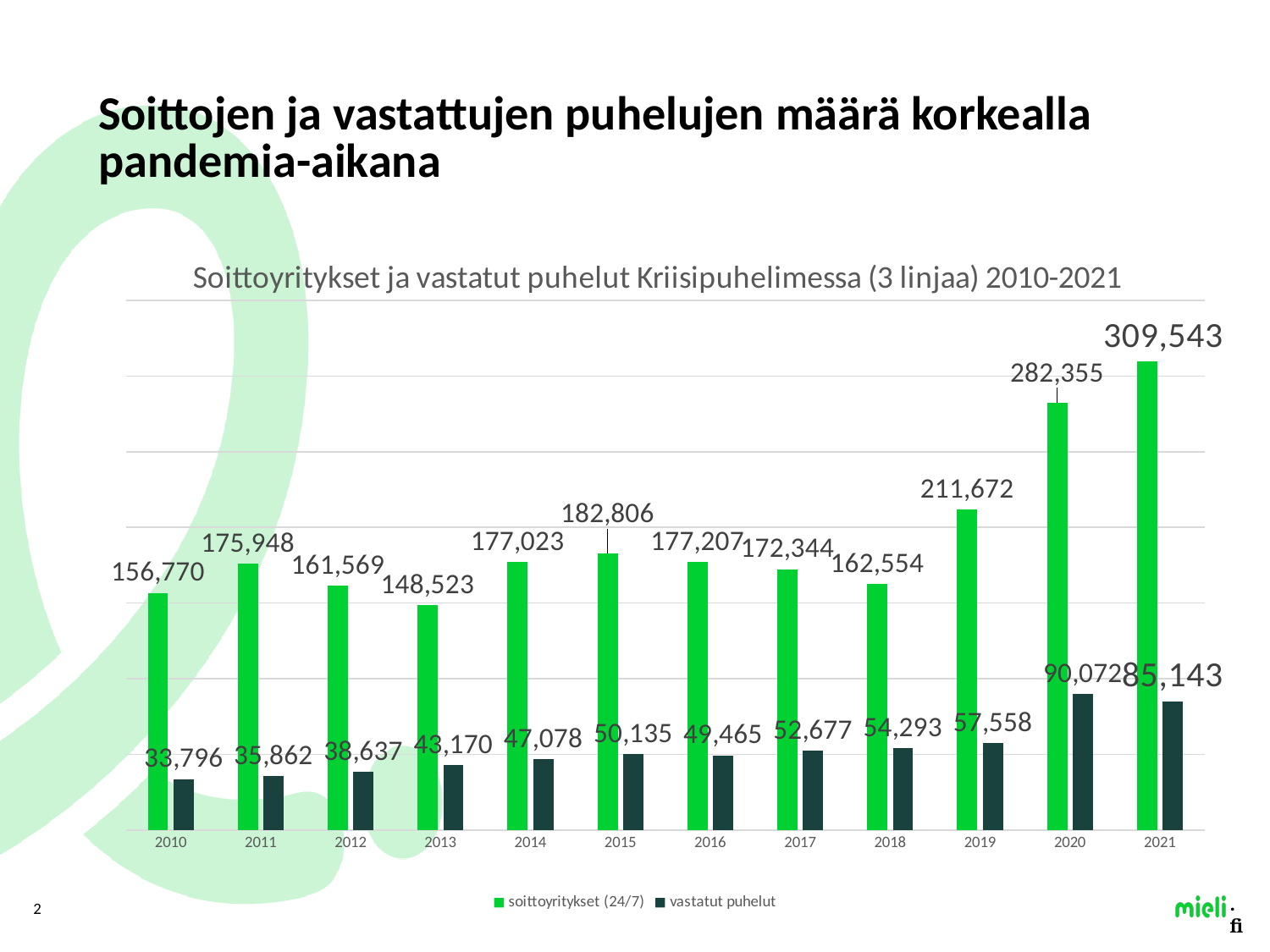
What is the value for soittoyritykset (24/7) in 2013? 148,523 Which year has the lowest value for soittoyritykset (24/7)? 2013 Which year has the highest value for soittoyritykset (24/7)? 2021 Which year has the highest value for vastatut puhelut? 2020 What is the difference between the soittoyritykset (24/7) values for 2021 and 2020? 27,188 Which is larger: vastatut puhelut in 2020 or in 2021? 2020 How many years are shown on the x axis? 12 Do the soittoyritykset (24/7) values rise or fall from 2018 to 2021? rise How many series does the legend list? 2 What is the value for vastatut puhelut in 2015? 50,135 What is the value for vastatut puhelut in 2020? 90,072 What is the value for soittoyritykset (24/7) in 2021? 309,543